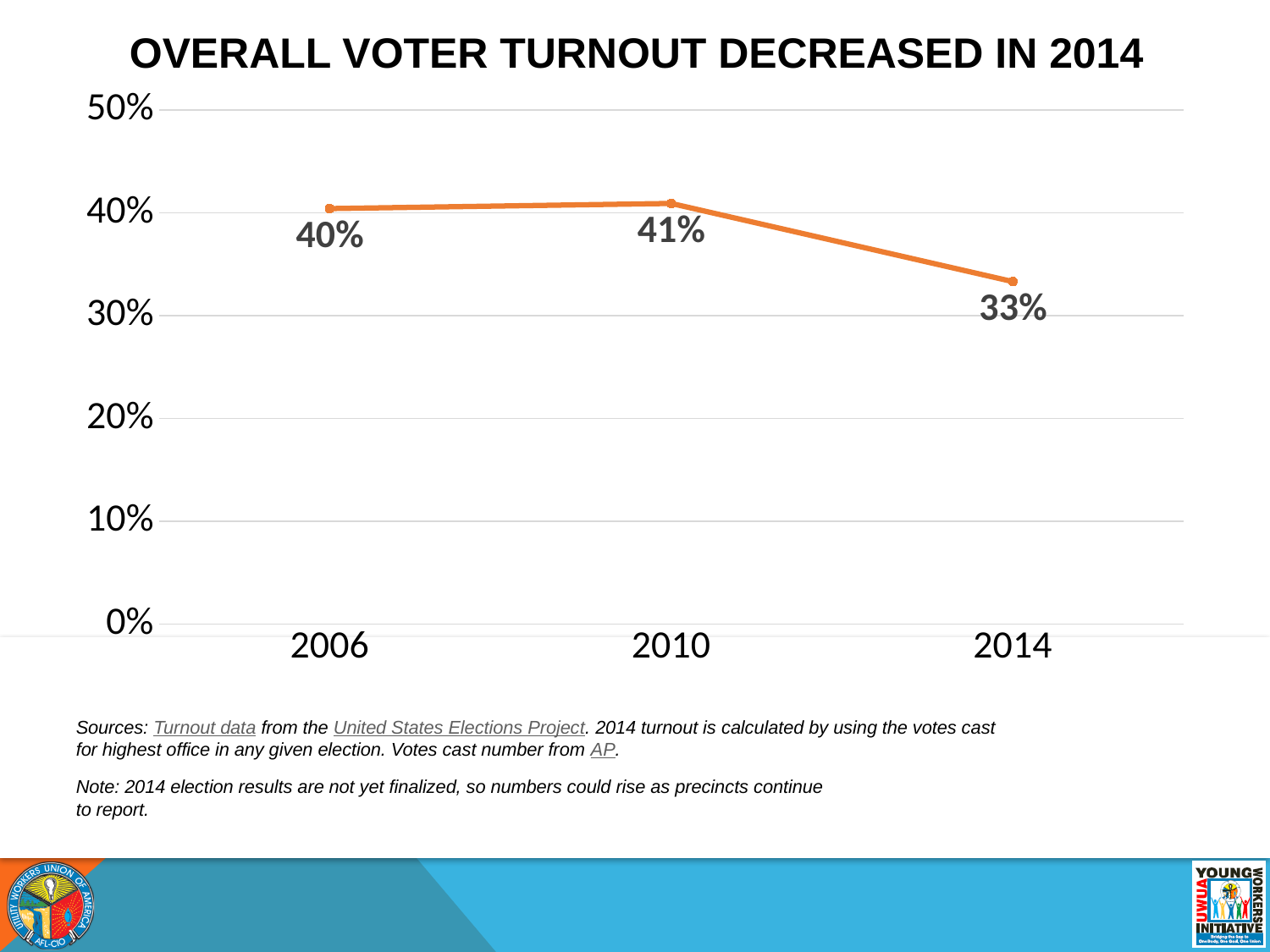
Which year had the highest voter turnout? 2010 Is the voter turnout for 2014 greater or less than 40%? less What was the voter turnout in 2010? 41% By how many percentage points did voter turnout fall from 2010 to 2014? 8 percentage points What is the difference in voter turnout between 2006 and 2014? 7 percentage points Which year had higher voter turnout, 2006 or 2014? 2006 What kind of chart is shown on the slide? Line chart What is the title of the chart? OVERALL VOTER TURNOUT DECREASED IN 2014 What was the voter turnout in 2006? 40% What was the voter turnout in 2014? 33% How many years are plotted on the chart? 3 Which year had the lowest voter turnout? 2014